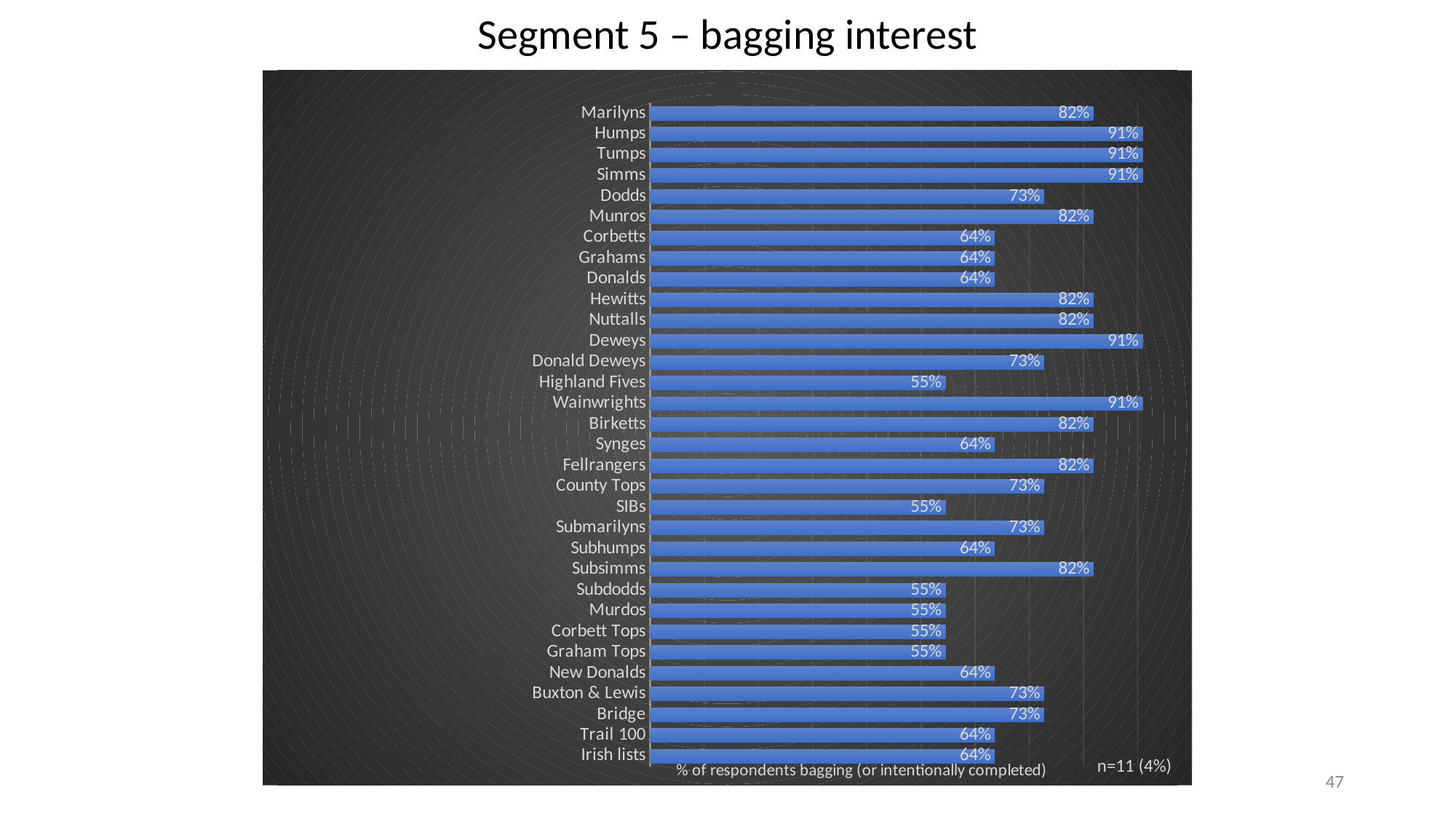
What kind of chart is shown on the slide? Bar chart What is the value for Dodds? 73% Which has a larger value, Munros or SIBs? Munros What is the value for Marilyns? 82% What is the lowest percentage shown on the chart? 55% What is the value for Irish lists? 64% What is the title of the slide? Segment 5 – bagging interest What is the value for Highland Fives? 55% How many categories are shown on the chart? 32 What is the highest percentage shown on the chart? 91% What is the value for Wainwrights? 91% What is the difference between the values for Humps and Corbetts? 27%